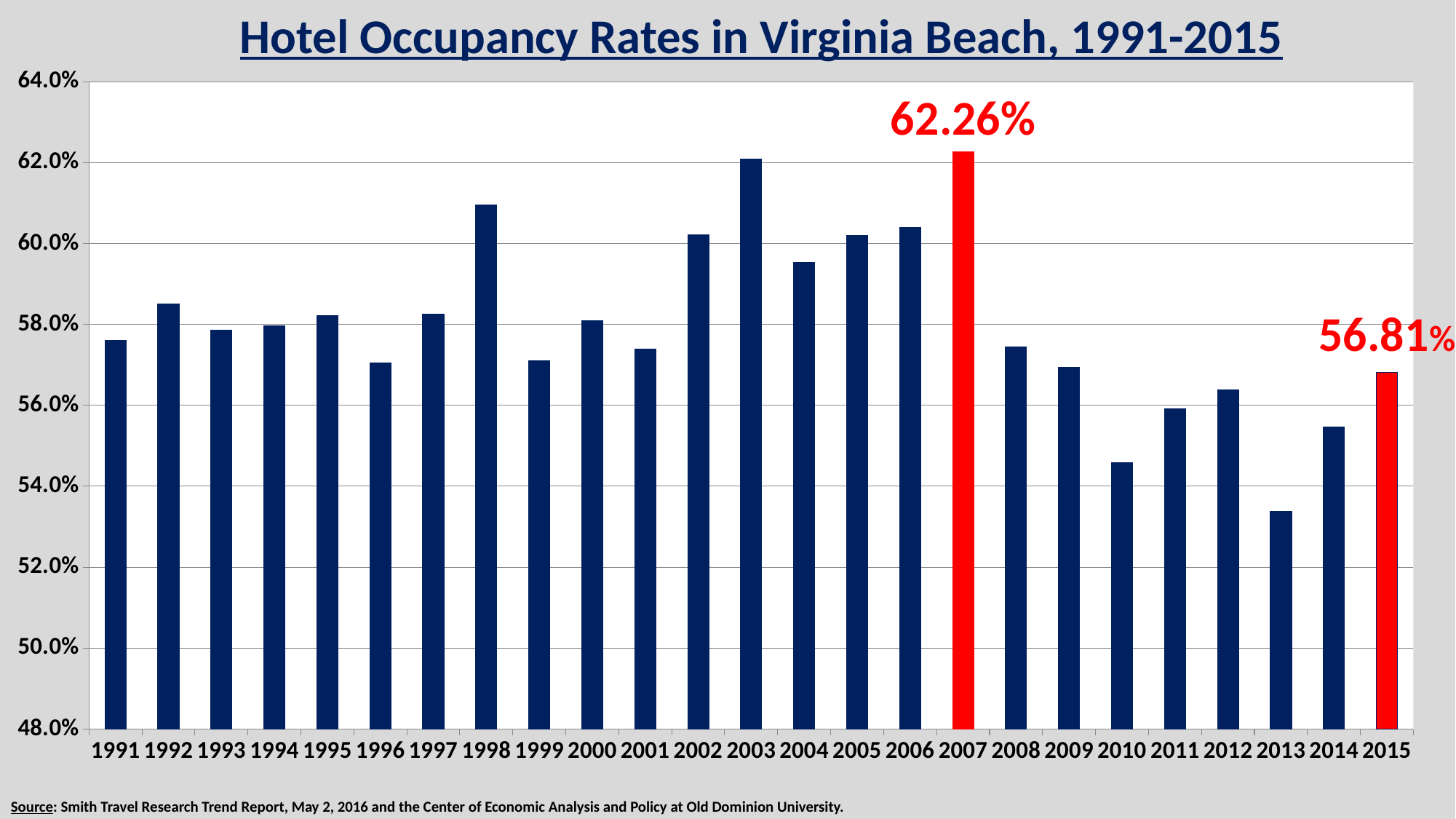
What is the difference between the 2007 and 2015 occupancy rates? 5.45 percentage points Which year has the higher occupancy rate, 1998 or 1999? 1998 Is the occupancy rate for 2010 greater or less than 56.0%? less How many years are plotted on the chart? 25 Which year has the higher occupancy rate, 2007 or 2015? 2007 What is the hotel occupancy rate shown for 2007? 62.26% Is the occupancy rate for 1998 greater or less than 60.0%? greater What is the hotel occupancy rate shown for 2015? 56.81% What kind of chart is shown on the slide? Bar chart Which year has the lowest hotel occupancy rate on the chart? 2013 From 2007 to 2010, do the occupancy rates rise or fall? Fall Is the occupancy rate for 2013 greater or less than 54.0%? less